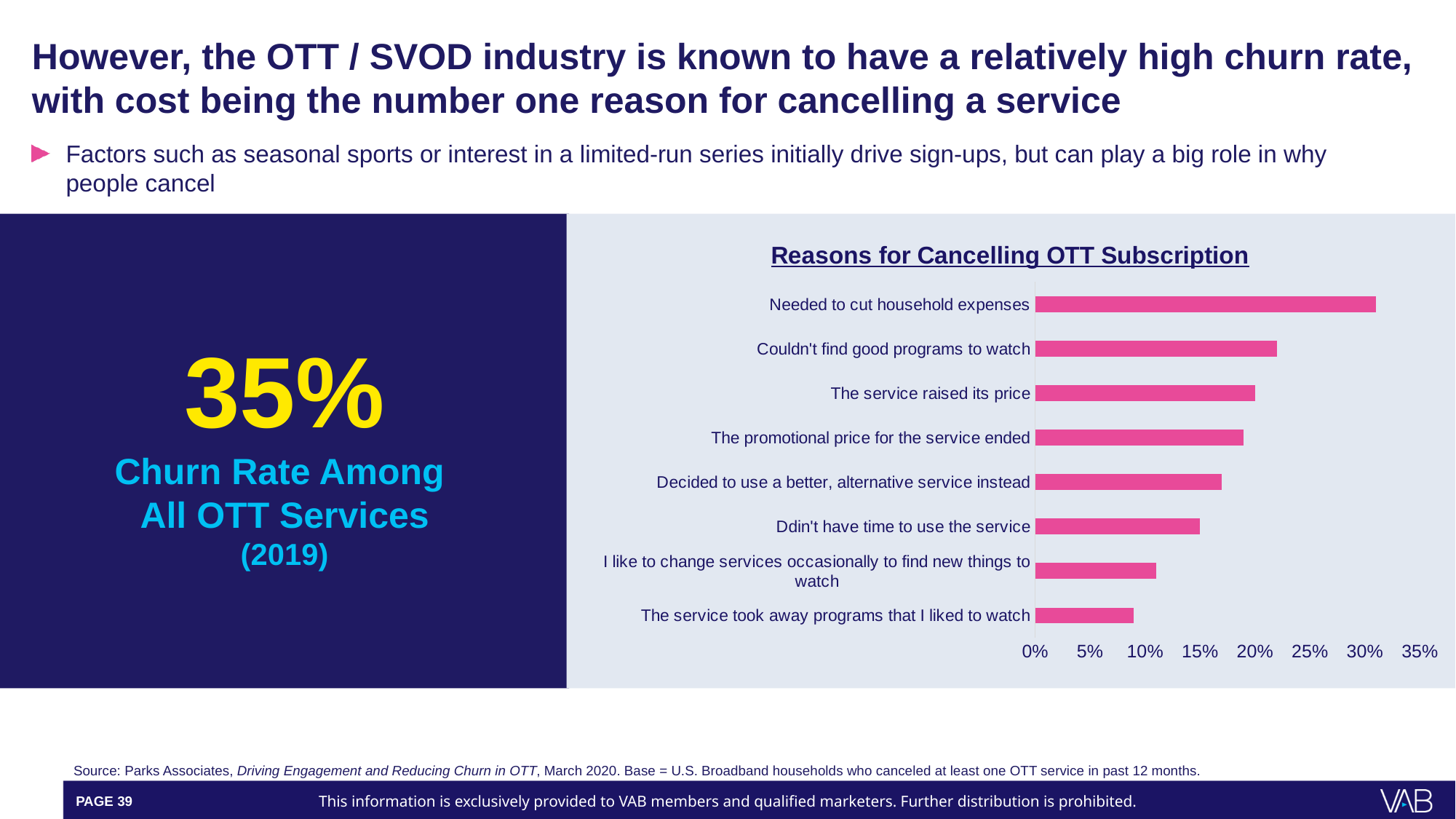
Which reason for cancelling has the highest value? Needed to cut household expenses Which is larger: the value for 'Decided to use a better, alternative service instead' or 'The service took away programs that I liked to watch'? Decided to use a better, alternative service instead Is the value for 'The service took away programs that I liked to watch' greater or less than 15%? less What colour are the bars in the chart? pink Which reason for cancelling has the lowest value? The service took away programs that I liked to watch Which is larger: the value for 'Needed to cut household expenses' or 'Couldn't find good programs to watch'? Needed to cut household expenses How many reasons for cancelling are listed in the chart? 8 Is the value for 'Couldn't find good programs to watch' greater or less than 20%? greater What is the title of the chart? Reasons for Cancelling OTT Subscription Is the value for 'The promotional price for the service ended' greater or less than 15%? greater What kind of chart is shown on the slide? bar chart